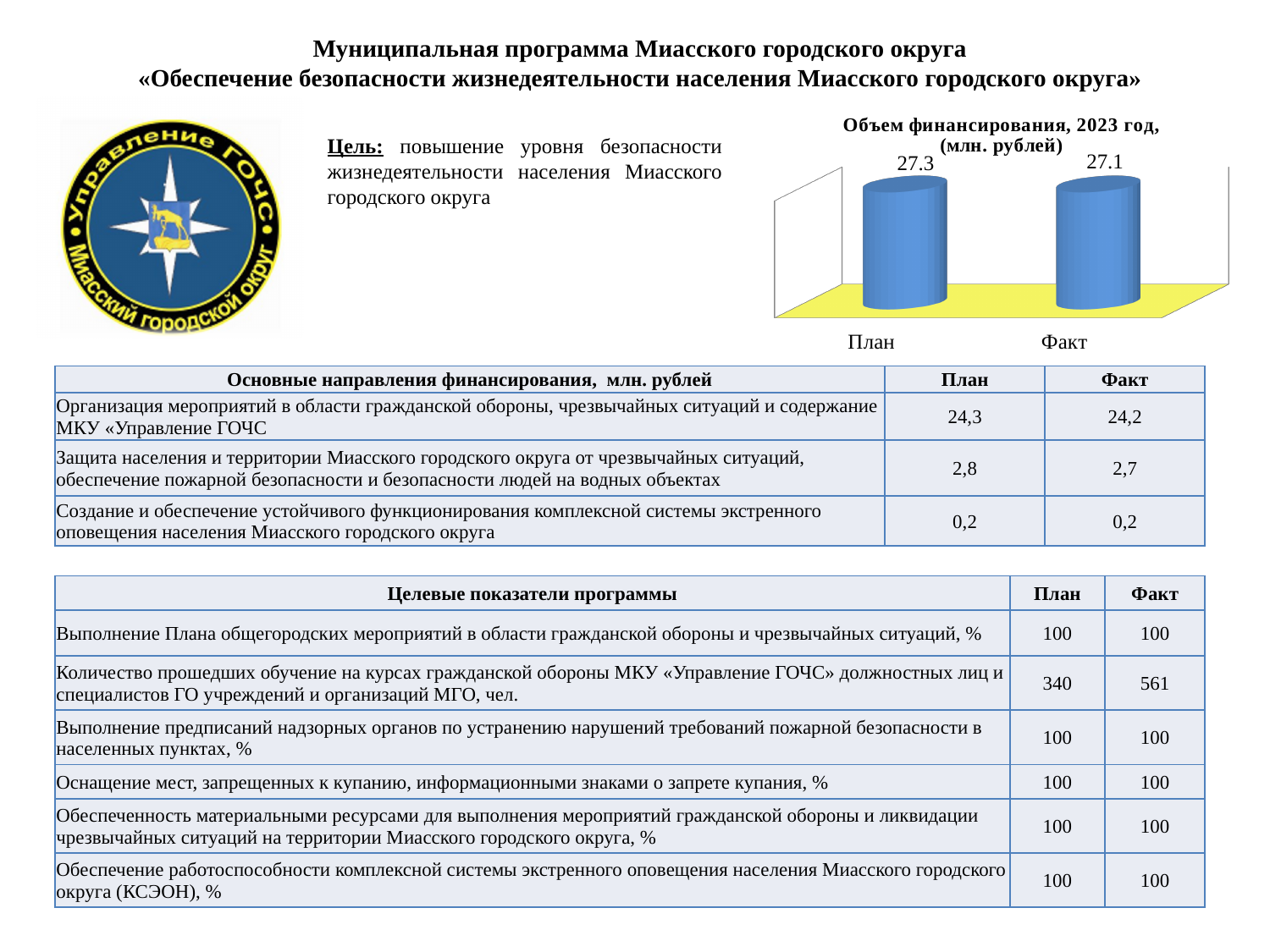
What is the value for План in the chart "Объем финансирования, 2023 год, (млн. рублей)"? 27.3 How many categories are shown in the chart "Объем финансирования, 2023 год, (млн. рублей)"? 2 In the chart "Объем финансирования, 2023 год, (млн. рублей)", which is larger: План or Факт? План Which category has the highest value in the chart "Объем финансирования, 2023 год, (млн. рублей)"? План What kind of chart is "Объем финансирования, 2023 год, (млн. рублей)"? Bar chart Which category has the lowest value in the chart "Объем финансирования, 2023 год, (млн. рублей)"? Факт Do the values rise or fall from План to Факт in the chart "Объем финансирования, 2023 год, (млн. рублей)"? Fall What colour are the bars in the chart "Объем финансирования, 2023 год, (млн. рублей)"? Blue What is the difference between the План and Факт values in the chart "Объем финансирования, 2023 год, (млн. рублей)"? 0.2 What is the value for Факт in the chart "Объем финансирования, 2023 год, (млн. рублей)"? 27.1 What is the title of the chart on the slide? Объем финансирования, 2023 год, (млн. рублей)